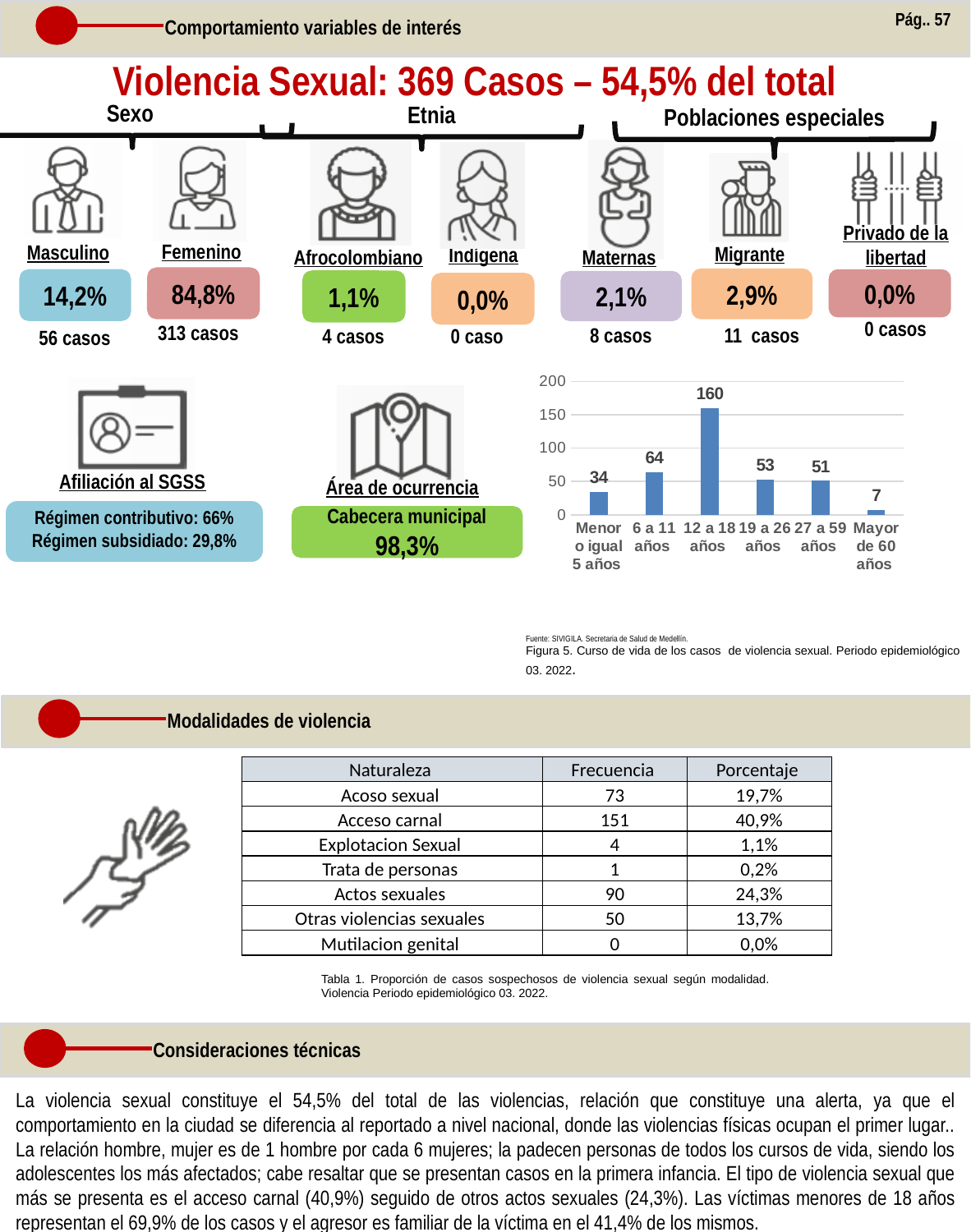
What type of chart is Figura 5 (cases by age group)? bar chart How many age-group categories are shown in the bar chart (Figura 5)? 6 In the bar chart of cases by age group, which age group has the highest value? 12 a 18 años In the bar chart of cases by age group (Figura 5), what is the value for '12 a 18 años'? 160 In the bar chart of cases by age group, which is larger: the value for '6 a 11 años' or the value for '19 a 26 años'? 6 a 11 años In the bar chart of cases by age group, which age group has the lowest value? Mayor de 60 años In the bar chart of cases by age group, what is the value for '19 a 26 años'? 53 In the bar chart of cases by age group, is the value for '12 a 18 años' greater or less than 150? greater In the bar chart of cases by age group, is the value for '27 a 59 años' greater or less than 100? less In the bar chart of cases by age group, what is the difference between the values for '12 a 18 años' and '6 a 11 años'? 96 In the bar chart of cases by age group, what is the value for 'Mayor de 60 años'? 7 In the bar chart of cases by age group, what is the value for 'Menor o igual 5 años'? 34